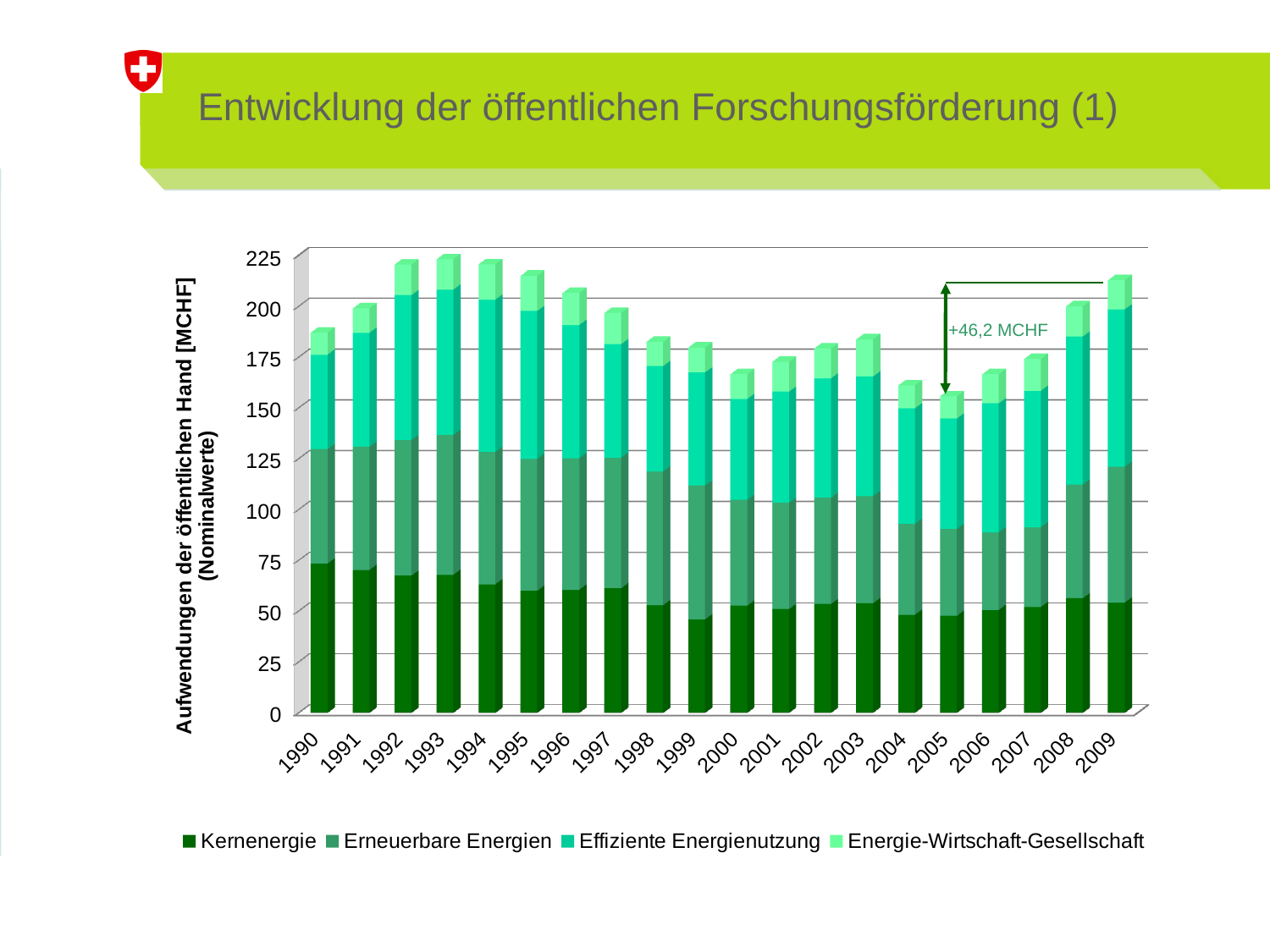
Is the total value for 2009 greater or less than 200? greater How many series does the legend list? 4 What kind of chart is shown on the slide? Stacked bar chart Do the total values rise or fall from 1993 to 2005? fall Which series is listed first in the legend? Kernenergie Is the total value for 1990 greater or less than 175? greater What is the label of the y axis? Aufwendungen der öffentlichen Hand [MCHF] (Nominalwerte) How many years are shown on the x axis of the chart? 20 Which year has the larger total, 1993 or 2005? 1993 Is the total value for 2000 greater or less than 175? less What increase is indicated by the annotation between 2005 and 2009? +46,2 MCHF